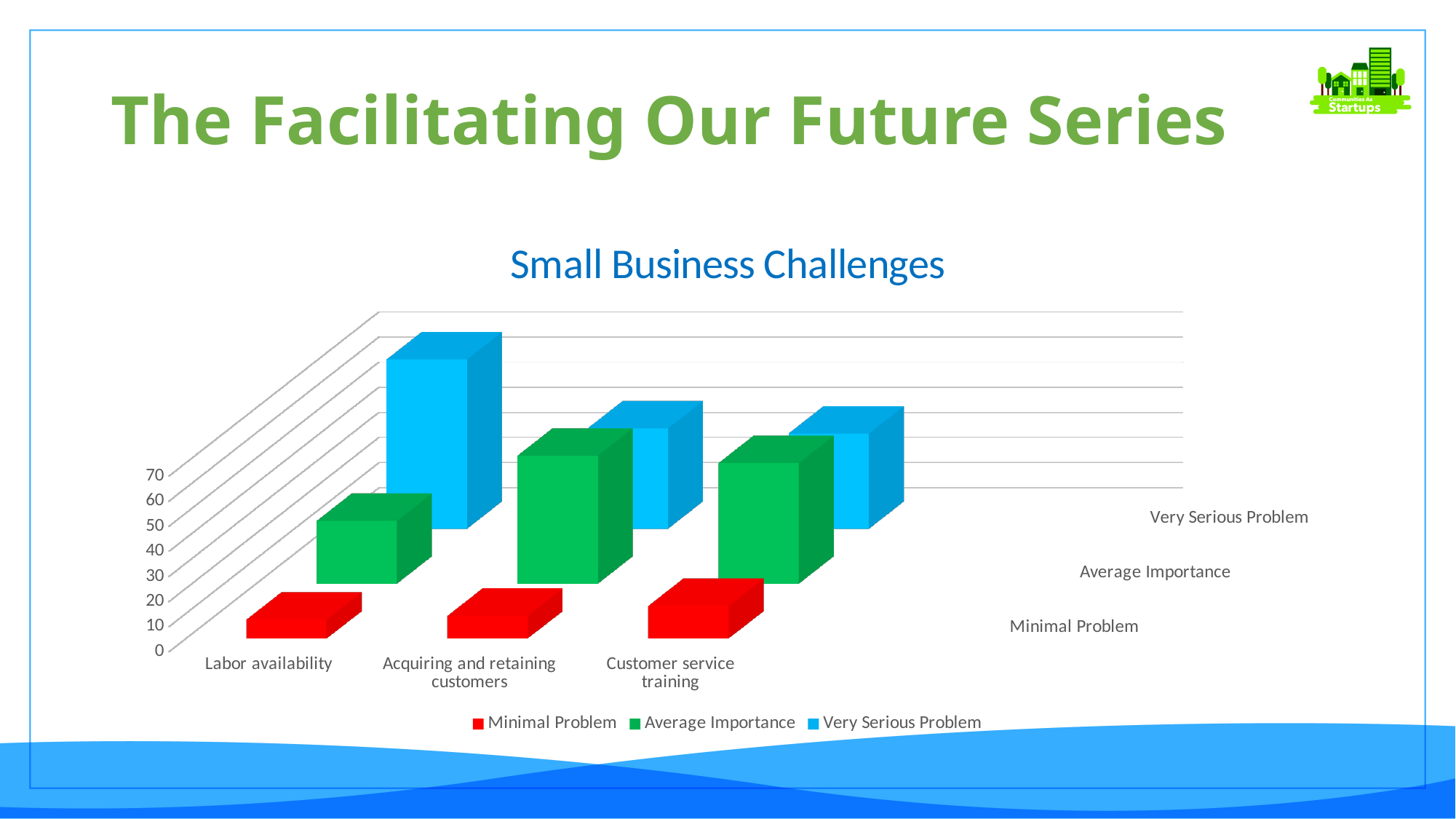
Which has the larger Average Importance value: Labor availability or Acquiring and retaining customers? Acquiring and retaining customers Which series has the tallest bar overall in the chart? Very Serious Problem Which series is shown in blue in the legend? Very Serious Problem For Labor availability, which is larger: Very Serious Problem or Average Importance? Very Serious Problem How many series does the legend list? 3 What type of chart is shown on the slide? Bar chart Is the Minimal Problem value for Labor availability greater or less than 30? less Which category has the highest Very Serious Problem value? Labor availability What is the title of the chart? Small Business Challenges How many categories are shown on the x axis? 3 Which category has the lowest Average Importance value? Labor availability For Customer service training, which is larger: Minimal Problem or Average Importance? Average Importance